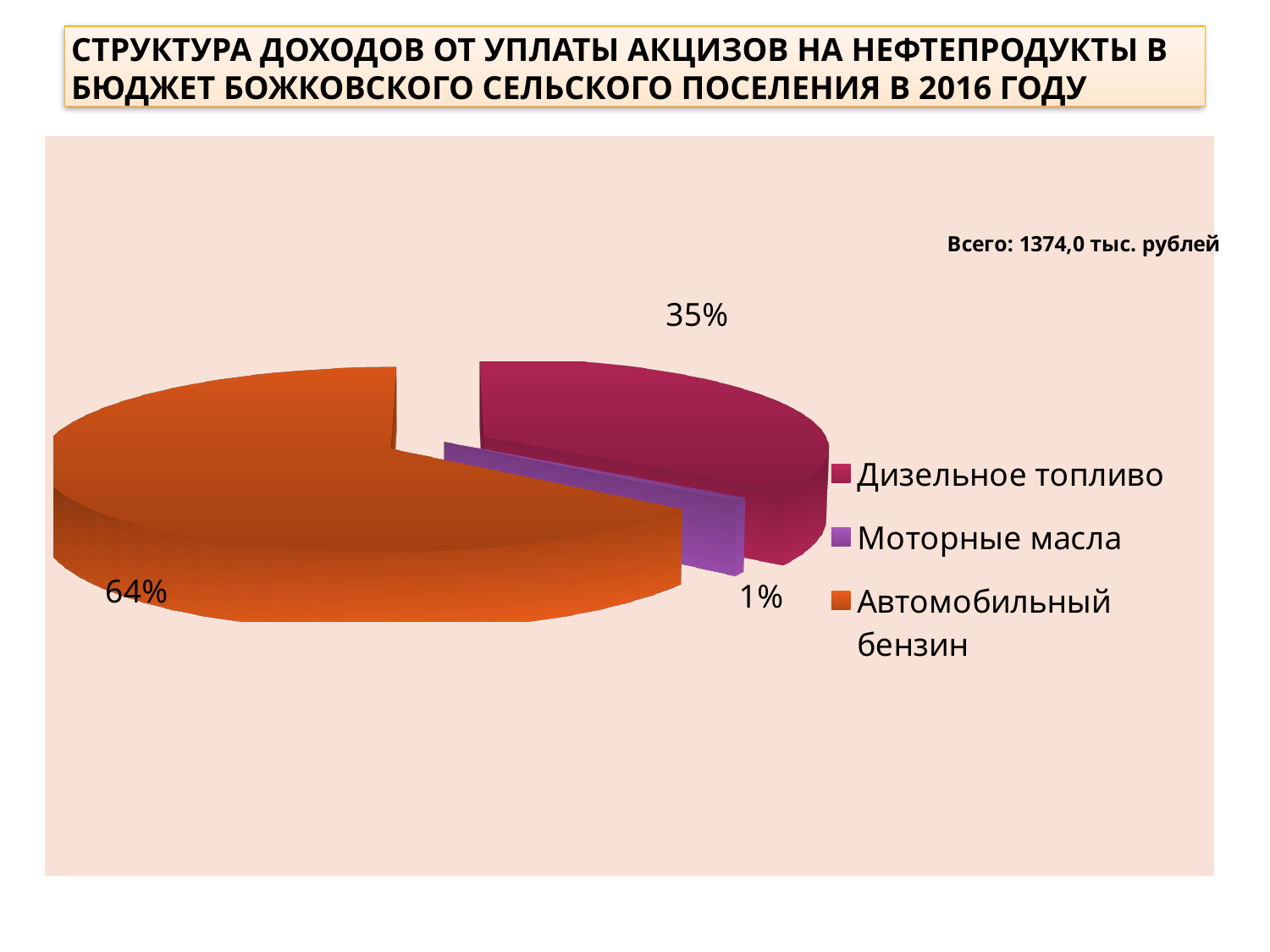
What is the difference in percentage points between the Автомобильный бензин and Дизельное топливо slices? 29 What share of the pie does Моторные масла account for? 1% What kind of chart is shown on the slide? pie chart Which category is shown in orange in the legend? Автомобильный бензин What share of the pie does Дизельное топливо account for? 35% How many categories are shown in the pie chart? 3 What total amount is stated on the chart? 1374,0 тыс. рублей Which category has the smallest slice of the pie? Моторные масла What share of the pie does Автомобильный бензин account for? 64% Which category has the largest slice of the pie? Автомобильный бензин Which is larger: the share for Дизельное топливо or the share for Моторные масла? Дизельное топливо